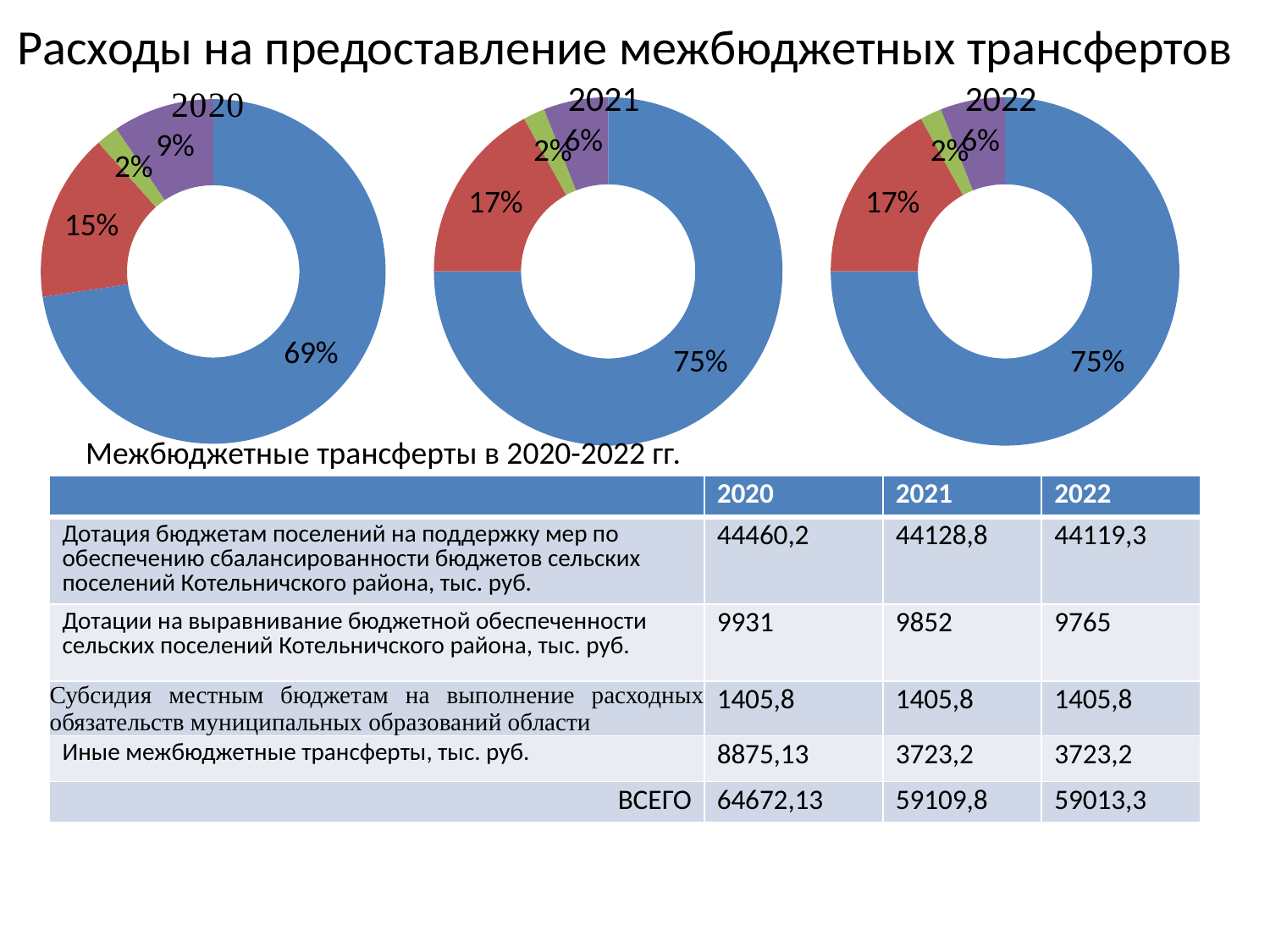
In the 2021 chart, what percentage is shown for the purple slice? 6% What type of chart is used for the 2020, 2021 and 2022 charts on this slide? Doughnut (pie) chart In the 2022 chart, what percentage is shown for the red slice? 17% How many slices does the 2022 chart have? 4 In the 2020 chart, what percentage is shown for the largest slice? 69% In the 2020 chart, what percentage is shown for the green slice? 2% What is the difference between the largest slice in the 2021 chart and the largest slice in the 2020 chart? 6 percentage points Is the red slice larger in the 2020 chart or in the 2021 chart? 2021 In the 2020 chart, what percentage is shown for the purple slice? 9% In the 2021 chart, what percentage is shown for the largest slice? 75% How many doughnut charts are shown on the slide? 3 In the 2020 chart, which slice is the smallest? The green slice (2%)